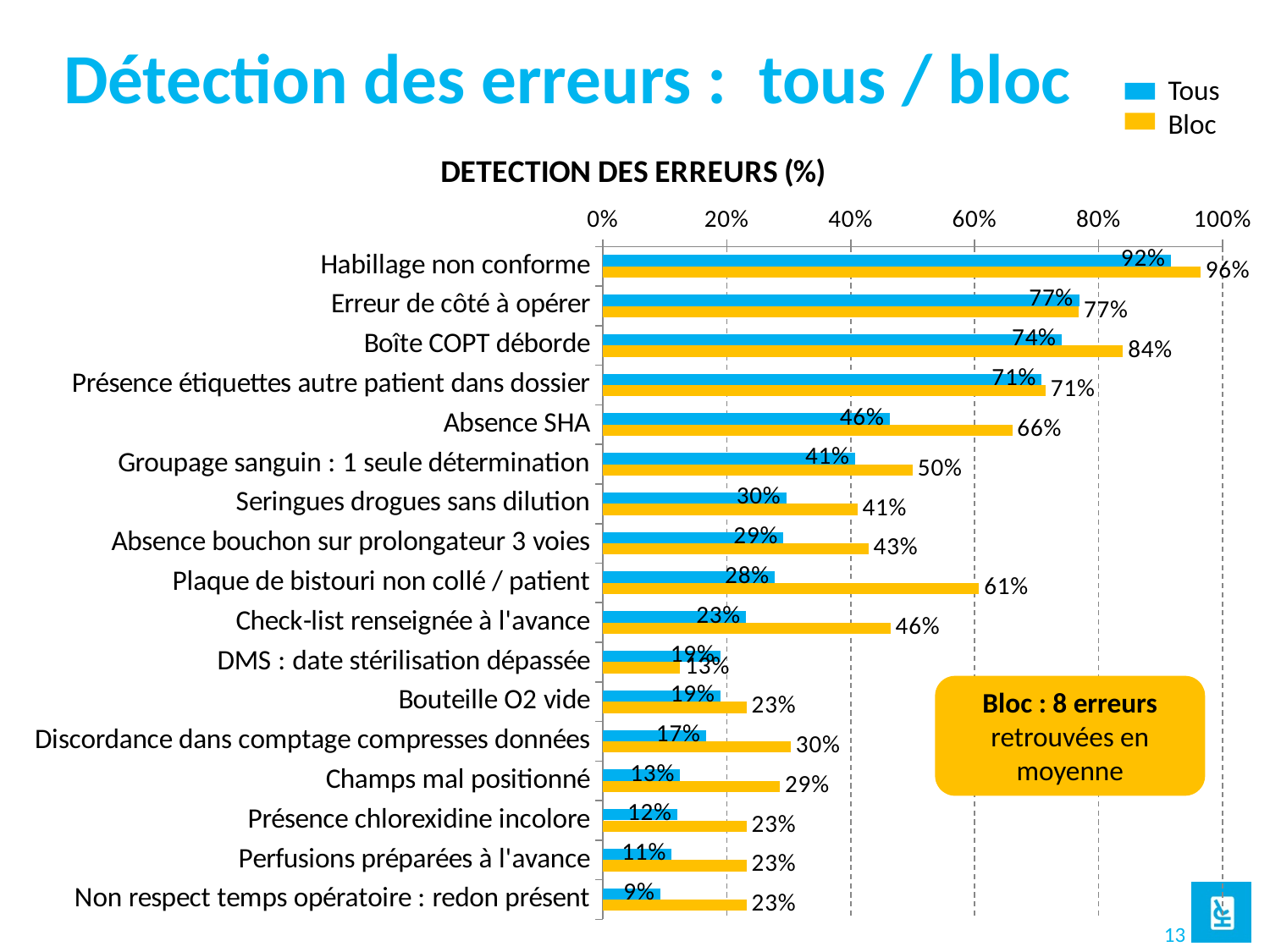
What is the Bloc value for Plaque de bistouri non collé / patient? 61% Which category has the lowest Tous value? Non respect temps opératoire : redon présent Which colour represents the Bloc series? Yellow How many series does the legend list? 2 What kind of chart is shown on the slide? Bar chart How many categories are shown on the chart? 17 What is the Tous value for Habillage non conforme? 92% What is the Bloc value for Absence SHA? 66% Which category has the highest Bloc value? Habillage non conforme What is the difference between the Bloc and Tous values for Check-list renseignée à l'avance? 23% Which is larger for Boîte COPT déborde, the Tous value or the Bloc value? Bloc What is the title of the chart? DETECTION DES ERREURS (%)